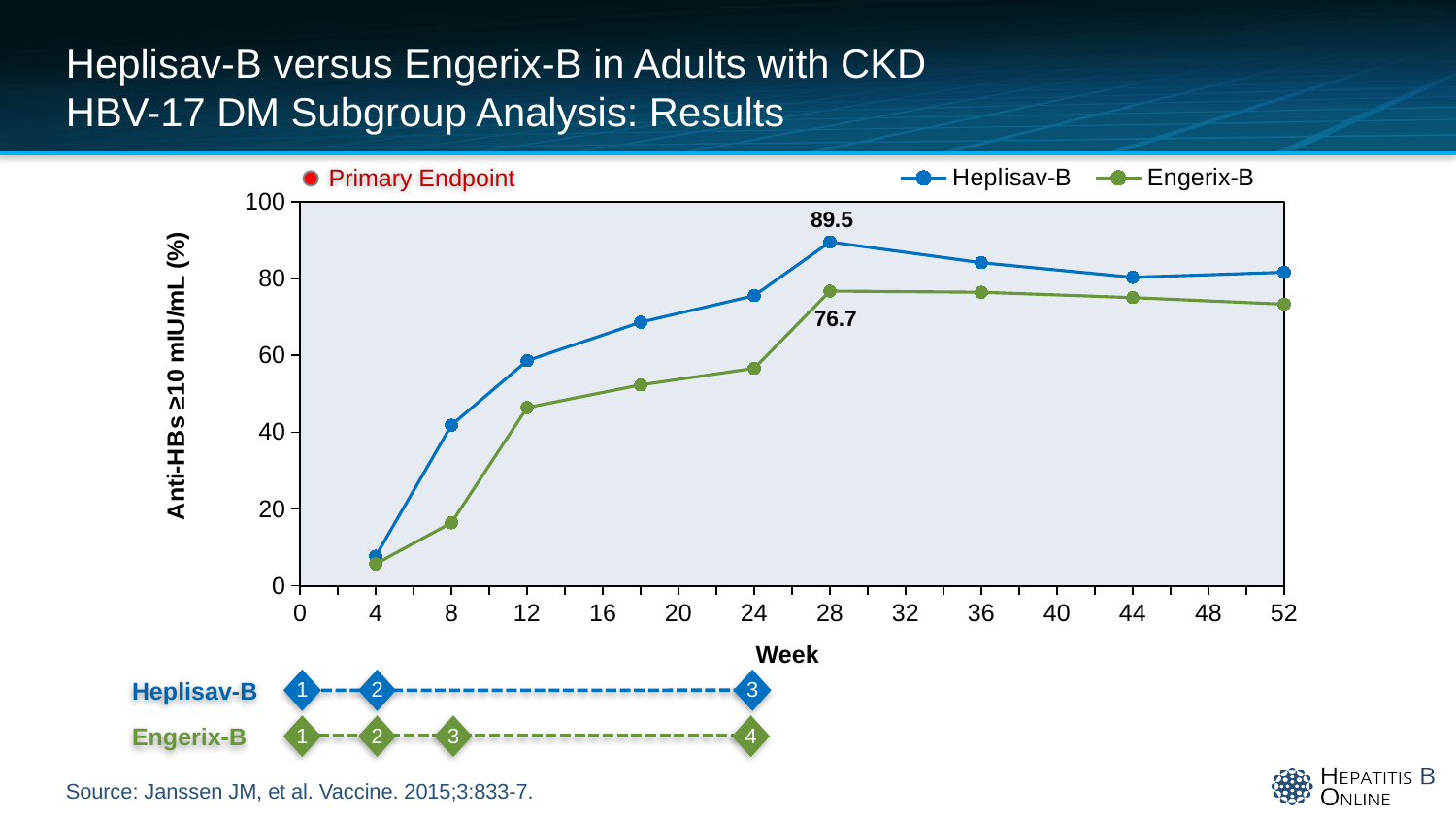
What is the Engerix-B value at week 28? 76.7 What is the Heplisav-B value at week 28? 89.5 At which week is the Engerix-B series at its lowest value? Week 4 What is the difference between the Heplisav-B and Engerix-B values at week 28? 12.8 Is the Engerix-B value at week 8 greater or less than 20? less Is the Heplisav-B value at week 12 greater or less than 40? greater Does the Heplisav-B series rise or fall from week 4 to week 28? Rise At week 8, which series has the higher value, Heplisav-B or Engerix-B? Heplisav-B What kind of chart is shown on the slide? Line chart How many series does the legend list? 2 How many data points are plotted for the Heplisav-B series? 9 At which week does the Heplisav-B series reach its highest value? Week 28